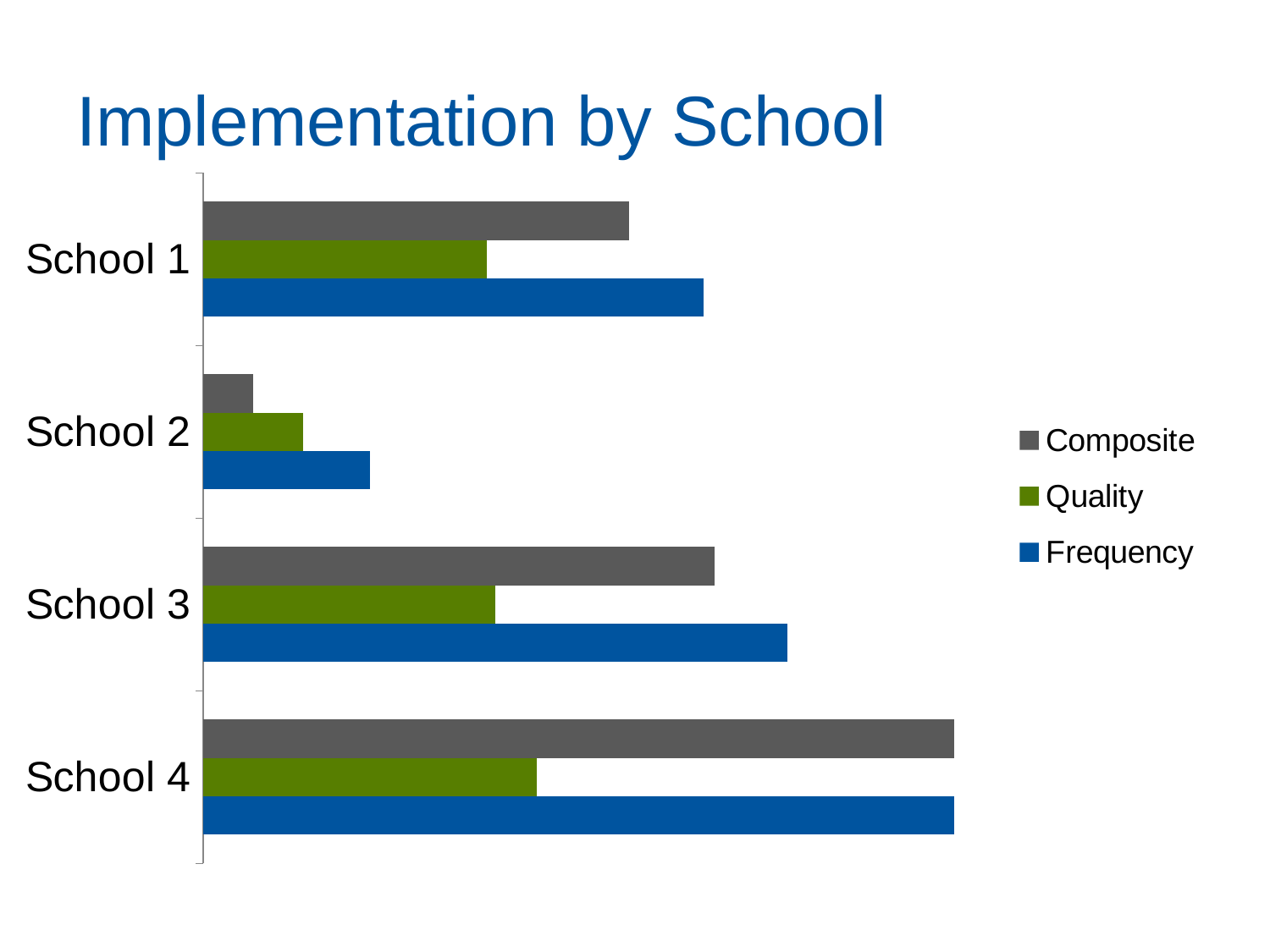
Which school has the lowest Composite value? School 2 Which school has the highest Frequency value? School 4 How many schools are shown on the chart? 4 What kind of chart is shown on the slide? Bar chart Which school has the lowest Frequency value? School 2 Which school has the lowest Quality value? School 2 What colour are the Quality bars? Green How many series does the legend list? 3 Which is larger, the Frequency value for School 1 or for School 3? School 3 Which is larger, the Composite value for School 1 or for School 3? School 3 For School 2, which series has the highest value? Frequency Which school has the highest Composite value? School 4